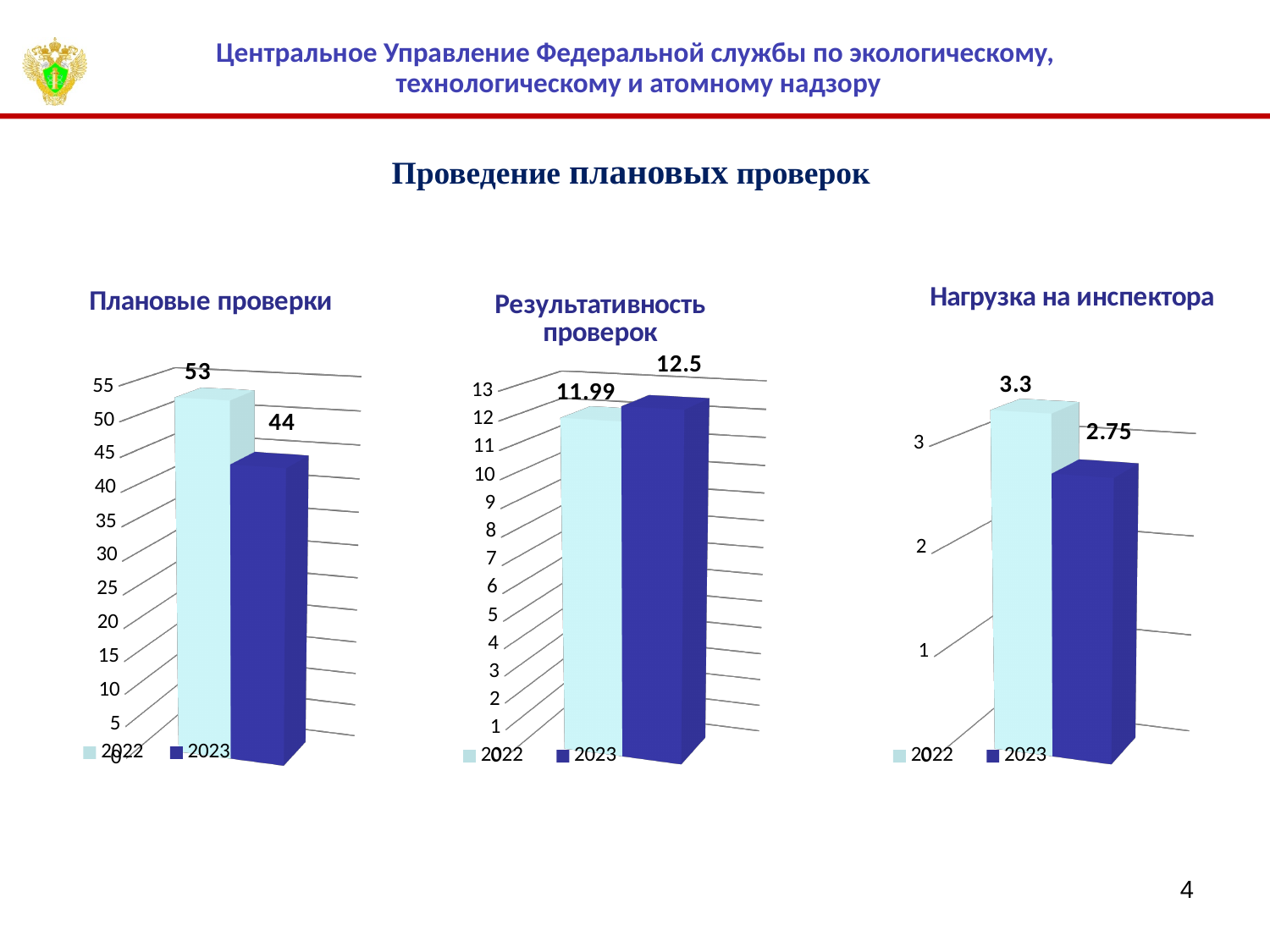
In the chart titled "Плановые проверки", what is the value for 2023? 44 In the chart titled "Нагрузка на инспектора", what is the value for 2022? 3.3 In the chart titled "Нагрузка на инспектора", what is the value for 2023? 2.75 In the chart titled "Нагрузка на инспектора", which year has the lower value? 2023 In the chart titled "Результативность проверок", what is the value for 2023? 12.5 In the chart titled "Результативность проверок", which year has the higher value? 2023 In the chart titled "Плановые проверки", what is the value for 2022? 53 In the chart titled "Результативность проверок", what is the value for 2022? 11.99 In the chart titled "Плановые проверки", is the value for 2023 greater or less than 45? less In the chart titled "Плановые проверки", what is the difference between the 2022 and 2023 values? 9 What kind of chart is the chart titled "Нагрузка на инспектора"? bar chart How many series does the legend of the chart titled "Плановые проверки" list? 2